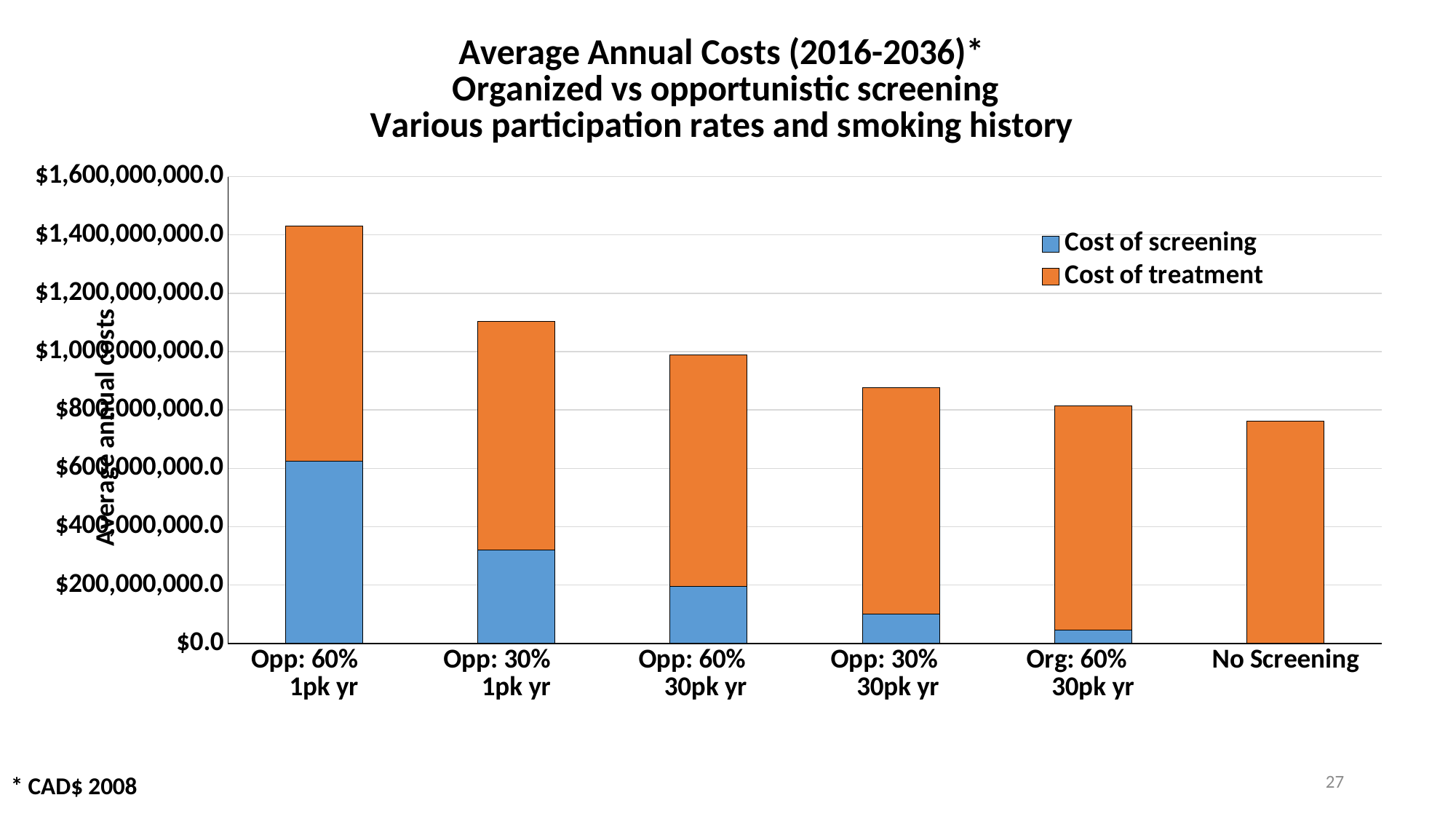
Is the total cost for Org: 60% 30pk yr greater or less than $1,000,000,000.0? less Which category has the highest total average annual cost? Opp: 60% 1pk yr Which category has the lowest total average annual cost? No Screening Which colour represents Cost of treatment in the legend? Orange Is the total cost for No Screening greater or less than $800,000,000.0? less How many series does the legend list? 2 What kind of chart is shown on the slide? Stacked bar chart Do the total costs rise or fall moving from left to right across the categories? Fall How many categories are shown along the x axis? 6 Is the cost of screening for Opp: 60% 1pk yr greater or less than $400,000,000.0? greater Which has a larger total cost: Opp: 30% 1pk yr or Opp: 60% 30pk yr? Opp: 30% 1pk yr